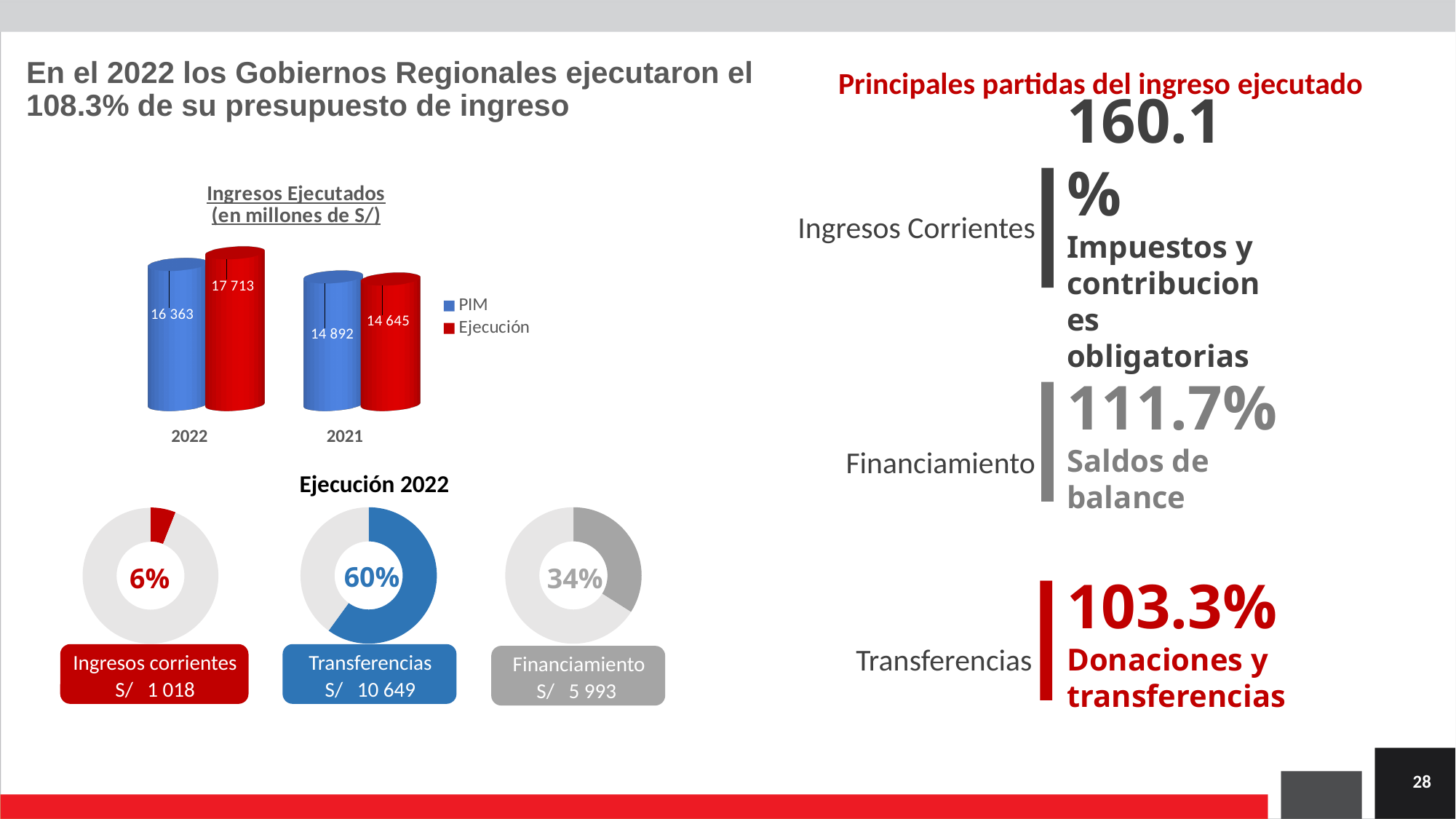
In the 'Ejecución 2022' donut charts, what share is shown for Transferencias? 60% In the 'Ingresos Ejecutados' chart, what is the PIM value for 2021? 14 892 In the 'Ingresos Ejecutados' chart, what is the Ejecución value for 2021? 14 645 In the 'Ingresos Ejecutados' chart, what is the difference between Ejecución and PIM in 2022? 1 350 In the 'Ingresos Ejecutados' chart, which year has the highest Ejecución value? 2022 In the 'Ingresos Ejecutados' chart, what is the PIM value for 2022? 16 363 In the 'Ingresos Ejecutados' chart, what is the Ejecución value for 2022? 17 713 In the 'Ingresos Ejecutados' chart, which colour represents Ejecución? Red In the 'Ingresos Ejecutados' chart, which is larger in 2021, PIM or Ejecución? PIM In the 'Ejecución 2022' donut charts, what share is shown for Financiamiento? 34% In the 'Ingresos Ejecutados' chart, how many series does the legend list? 2 What kind of chart is the 'Ingresos Ejecutados' chart? Bar chart